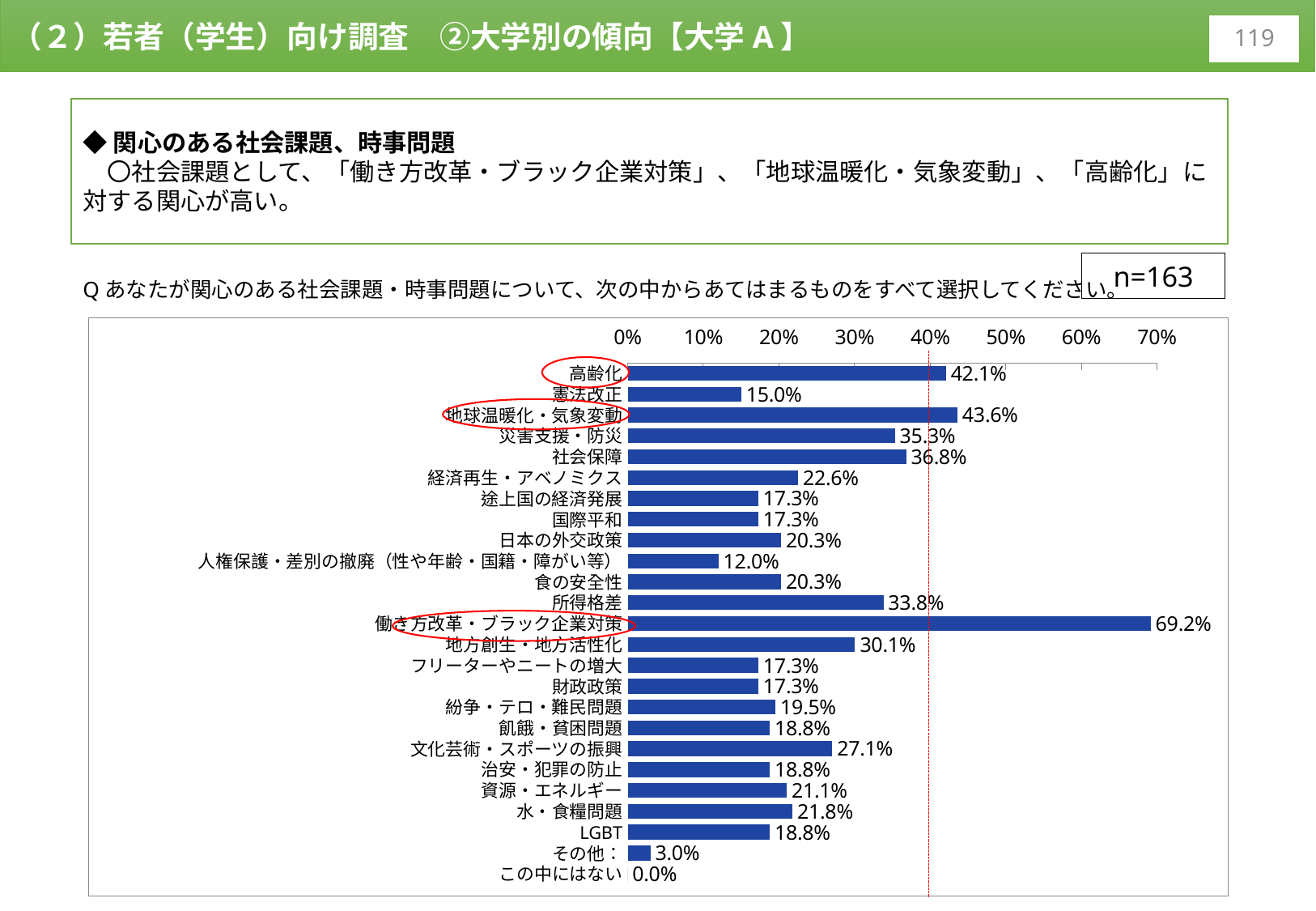
What is the difference between the values for 地球温暖化・気象変動 and 高齢化? 1.5% What is the value for その他：? 3.0% Which is larger, the value for 社会保障 or the value for 災害支援・防災? 社会保障 What is the value for 人権保護・差別の撤廃（性や年齢・国籍・障がい等）? 12.0% What is the value for 地球温暖化・気象変動? 43.6% What kind of chart is shown on the slide? bar chart What is the sample size (n) shown next to the question text? n=163 Which category has the highest value? 働き方改革・ブラック企業対策 Is the value for 所得格差 greater or less than 30%? greater What is the value for 働き方改革・ブラック企業対策? 69.2% How many categories are shown in the chart? 25 Which category has the lowest value? この中にはない